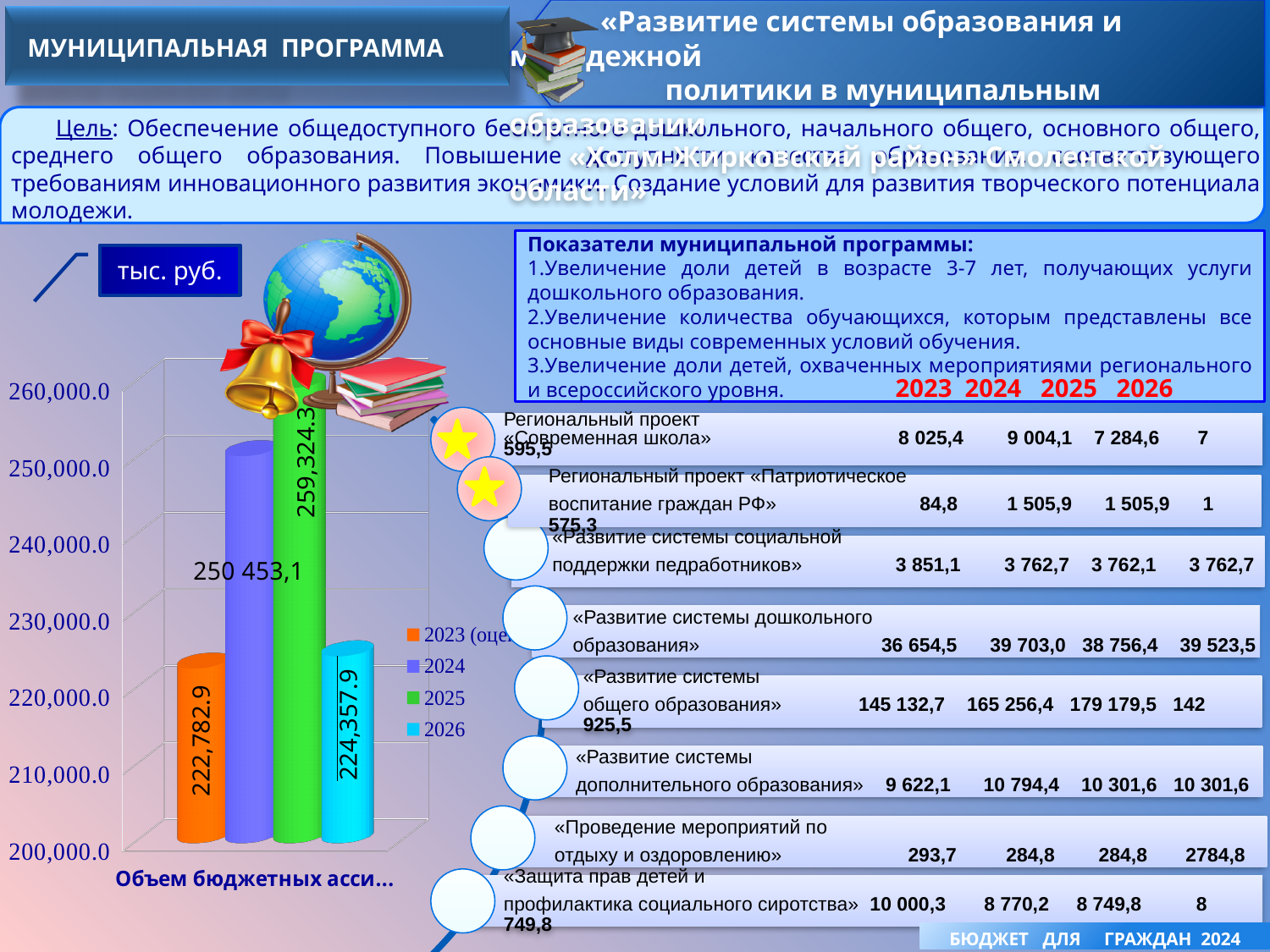
What is the value for 2025 in the bar chart? 259,324.3 What is the value for 2024 in the bar chart? 250 453,1 What is the value for 2023 (оценка) in the bar chart? 222,782.9 Which year has the lowest value in the bar chart? 2023 (оценка) What kind of chart is shown on the left of the slide? bar chart What is the difference between the values for 2025 and 2023 in the bar chart? 36,541.4 How many entries does the legend of the bar chart list? 4 Is the value for 2024 in the bar chart greater or less than 240,000.0? greater Which is larger in the bar chart, the value for 2024 or the value for 2026? 2024 How many bars are plotted in the bar chart? 4 Which year has the highest value in the bar chart? 2025 What is the value for 2026 in the bar chart? 224,357.9